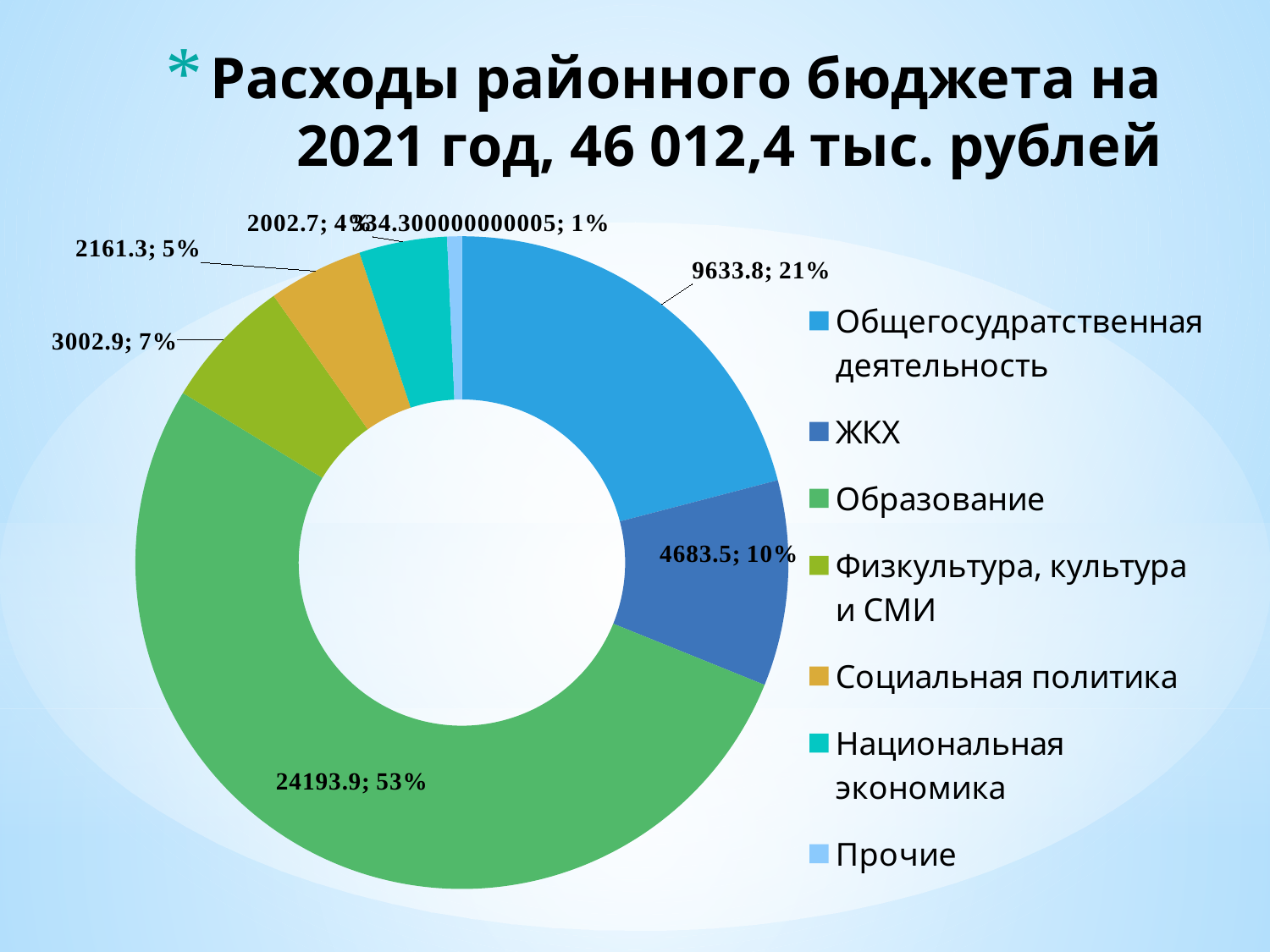
What share of the chart does Общегосударственная деятельность represent? 21% What is the value for Национальная экономика? 2002.7 What is the value for Образование? 24193.9 What is the difference between the values for Образование and Общегосударственная деятельность? 14560.1 What share of the chart does Физкультура, культура и СМИ represent? 7% What is the value for ЖКХ? 4683.5 What is the value for Социальная политика? 2161.3 What kind of chart is shown on the slide? Doughnut (pie) chart Which category has the smallest share of the budget? Прочие How many categories does the chart show? 7 Which category has the largest share of the budget? Образование Which is larger, the value for ЖКХ or the value for Физкультура, культура и СМИ? ЖКХ